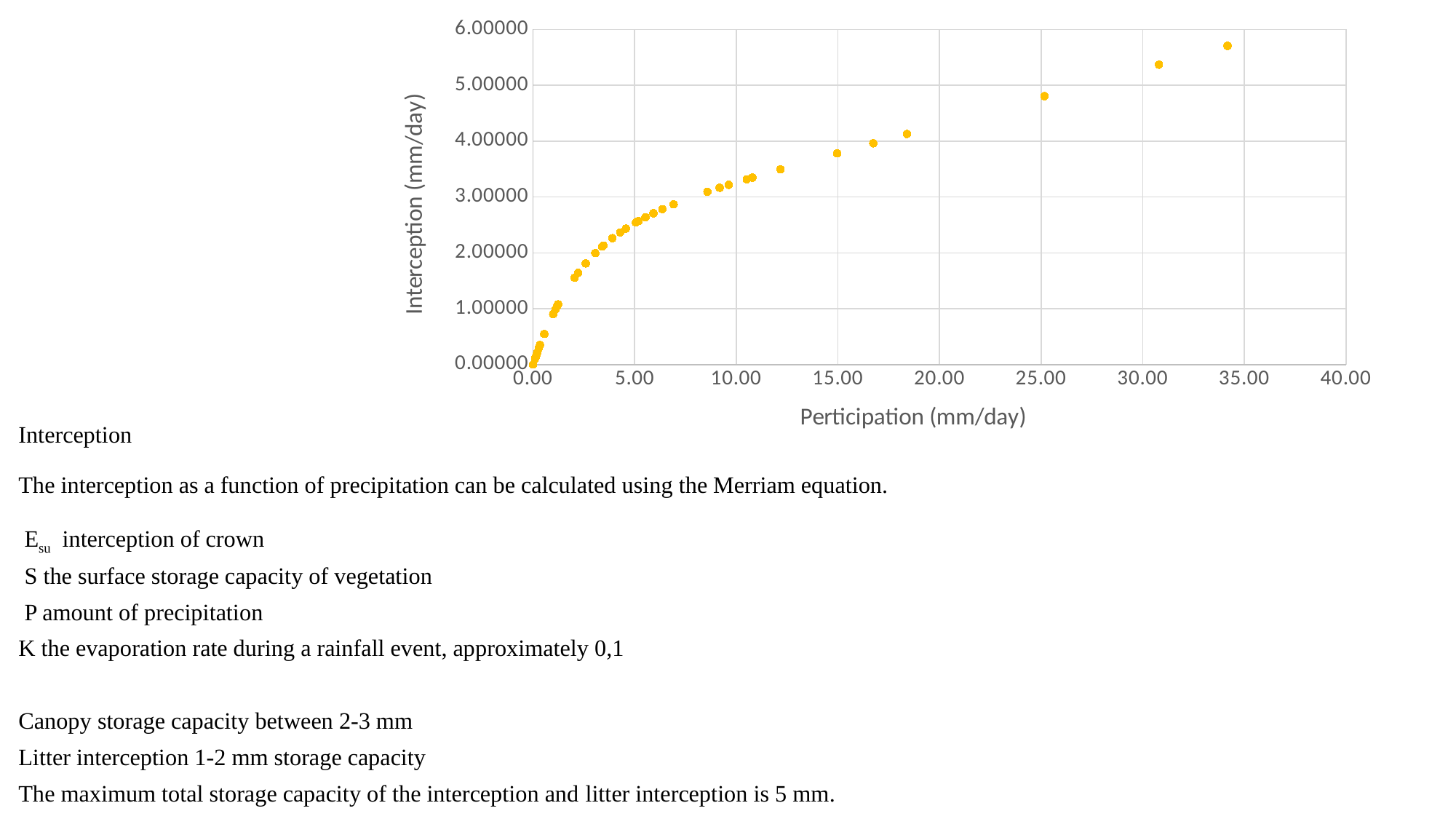
Is the interception value for the point at the highest precipitation (around 34 mm/day) greater or less than 5.00000? greater Is the interception value for the point at about 31 mm/day precipitation greater or less than 5.00000? greater Which point has the highest interception value: the one at about 34 mm/day or the one at about 25 mm/day precipitation? the one at about 34 mm/day What is the label of the x axis of the chart? Perticipation (mm/day) Is the interception value for the point at about 5 mm/day precipitation greater or less than 3.00000? less What kind of chart is shown on the slide? scatter chart What is the label of the y axis of the chart? Interception (mm/day) Do the interception values rise or fall as precipitation increases along the x axis? rise